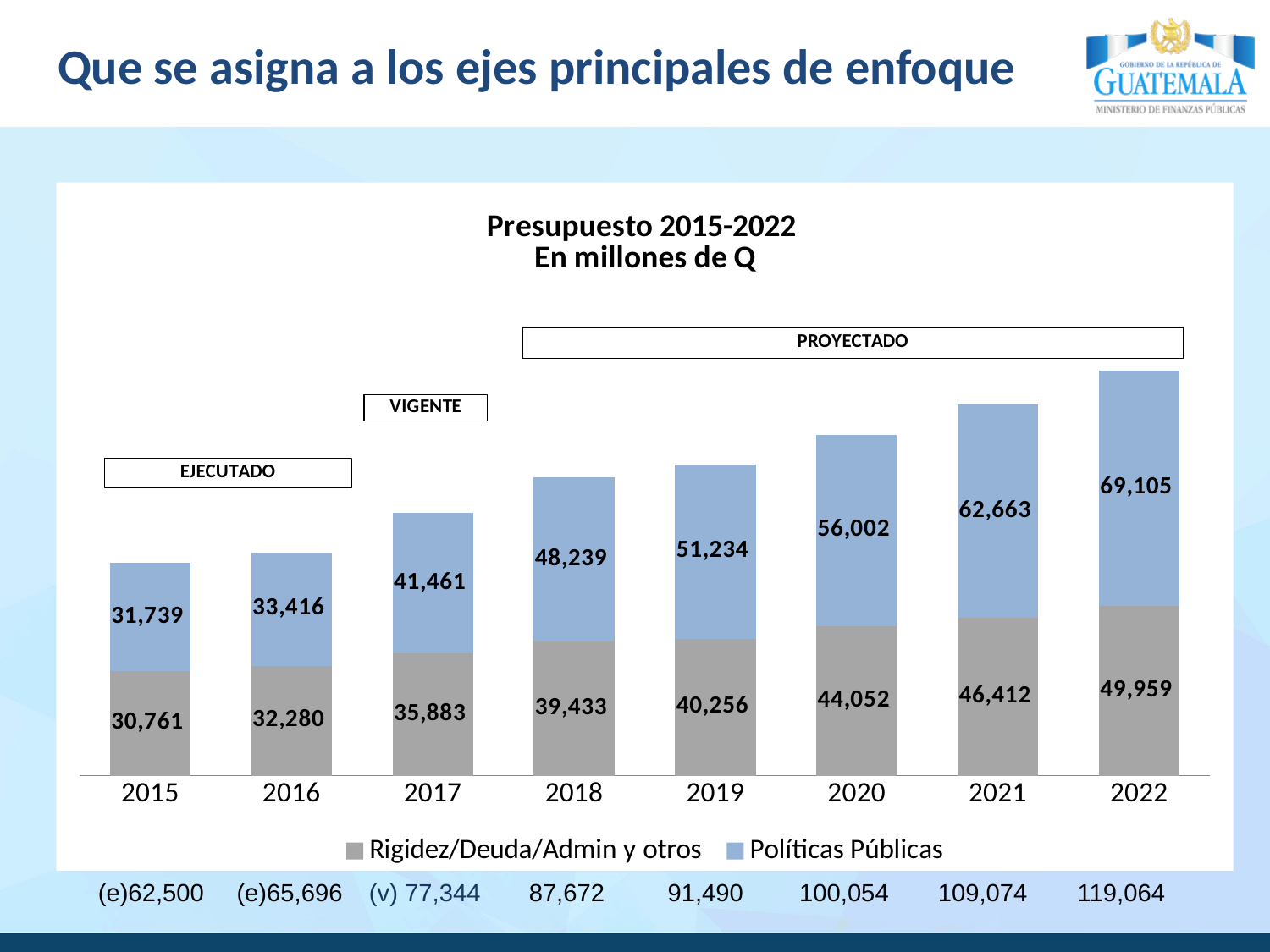
Which year has the highest value for Políticas Públicas? 2022 What is the value for Rigidez/Deuda/Admin y otros in 2015? 30,761 How many series does the legend list? 2 What is the difference between the Políticas Públicas values for 2021 and 2020? 6,661 What kind of chart is shown on the slide? Stacked bar chart Do the Políticas Públicas values rise or fall from 2015 to 2022? Rise What is the value for Políticas Públicas in 2022? 69,105 Which year has the lowest value for Rigidez/Deuda/Admin y otros? 2015 What is the value for Políticas Públicas in 2018? 48,239 In 2017, which is larger: Políticas Públicas or Rigidez/Deuda/Admin y otros? Políticas Públicas What is the total of the stacked bar for 2020? 100,054 How many years are shown on the x axis? 8